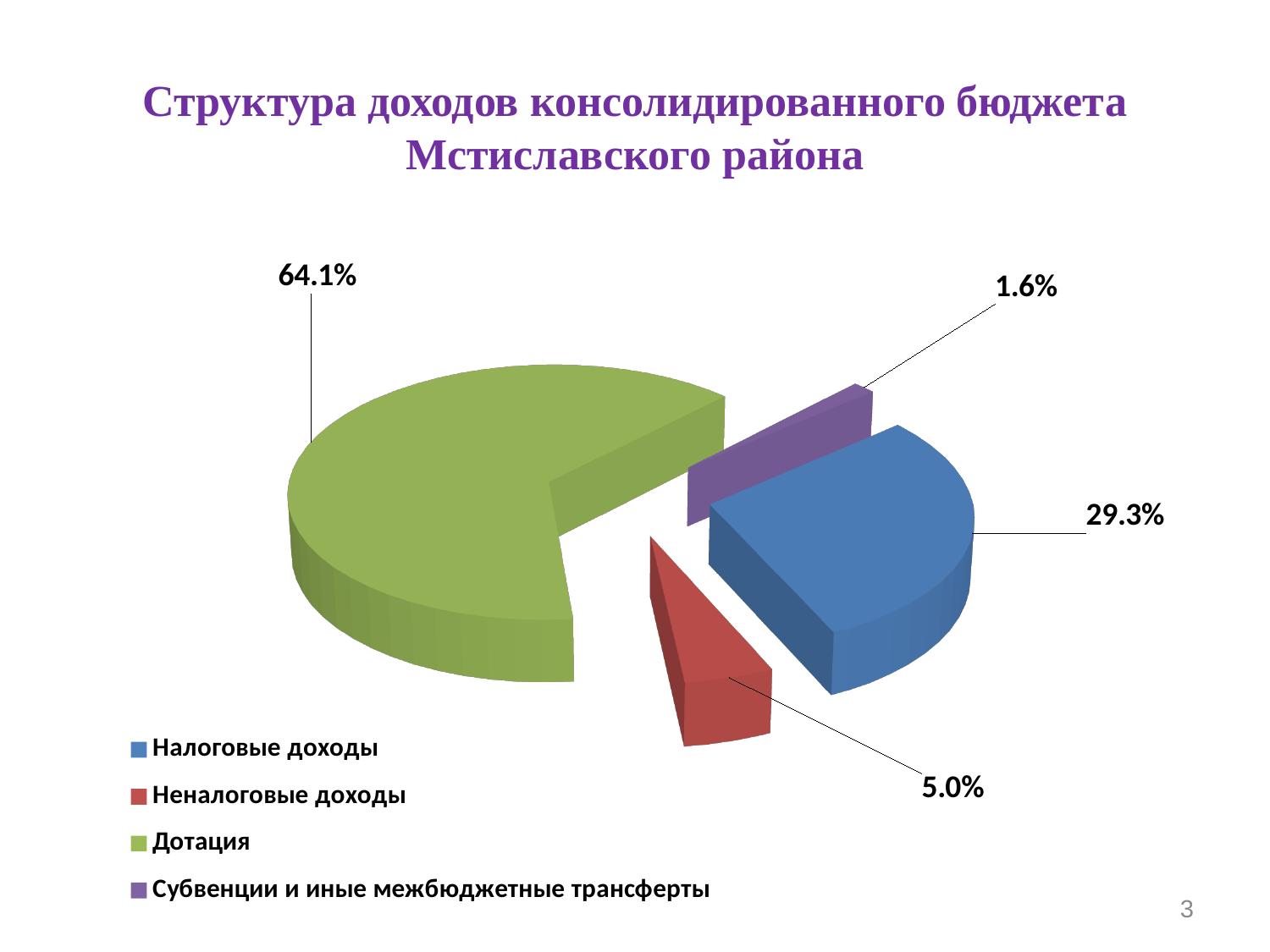
Which category has the largest share of the pie? Дотация Which is larger, the share of Неналоговые доходы or the share of Субвенции и иные межбюджетные трансферты? Неналоговые доходы How many categories does the pie chart have? 4 What is the difference between the shares of Дотация and Налоговые доходы? 34.8% Which category has the smallest share of the pie? Субвенции и иные межбюджетные трансферты What colour is the slice for Налоговые доходы? Blue What is the value shown for Налоговые доходы? 29.3% What is the value shown for Неналоговые доходы? 5.0% What is the value shown for Субвенции и иные межбюджетные трансферты? 1.6% What is the title of the chart on the slide? Структура доходов консолидированного бюджета Мстиславского района What kind of chart is shown on the slide? Pie chart What share of the pie does Дотация have? 64.1%